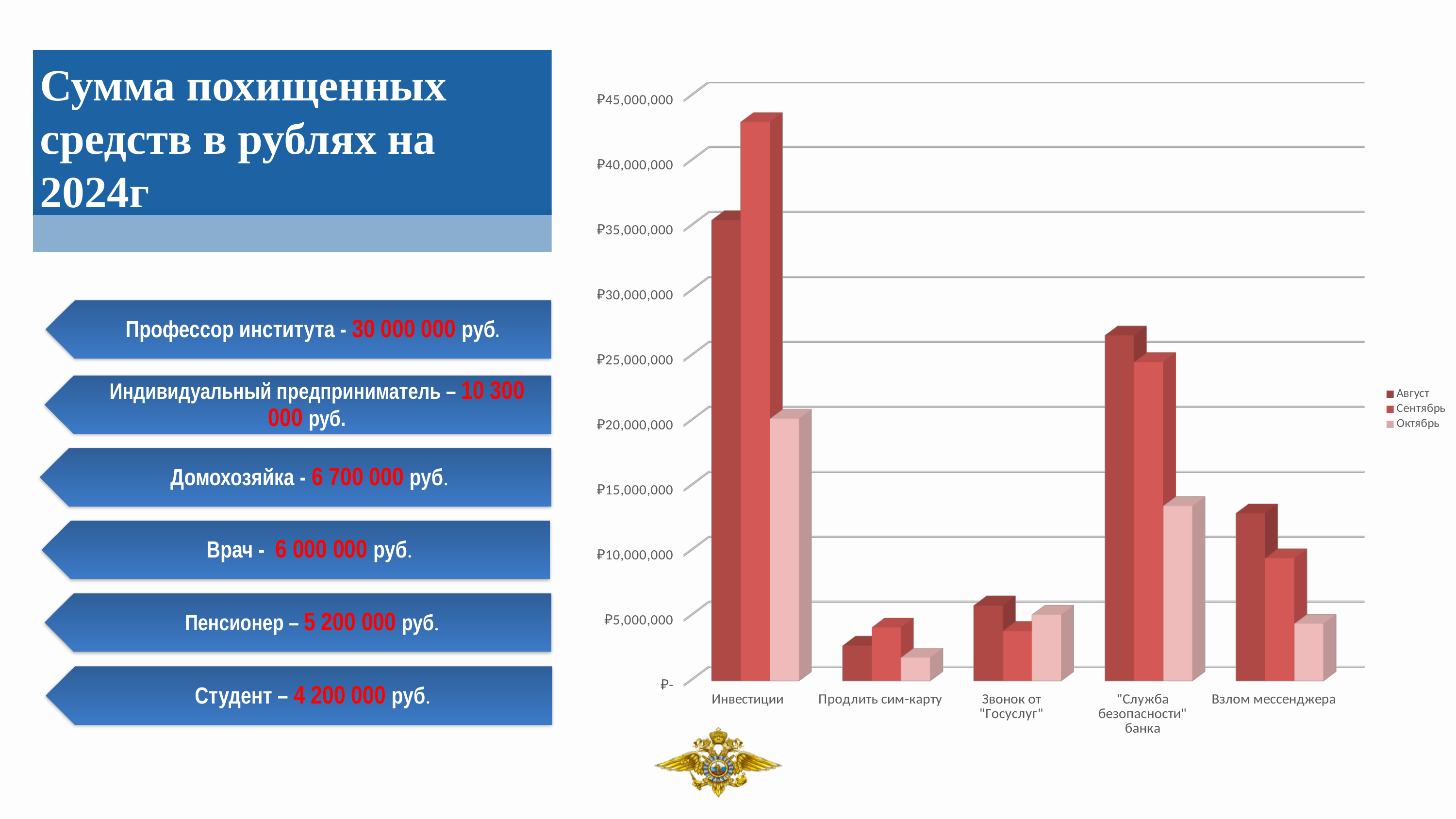
Is the Август value for Взлом мессенджера greater or less than ₽10,000,000? greater How many categories are shown on the x axis of the chart? 5 What kind of chart is shown on the slide? bar chart For Инвестиции, which is larger: the Август value or the Сентябрь value? Сентябрь How many series does the chart legend list? 3 For "Служба безопасности" банка, which is larger: the Август value or the Октябрь value? Август Which category has the highest value for Сентябрь? Инвестиции Is the Сентябрь value for Инвестиции greater or less than ₽40,000,000? greater Is the Октябрь value for Взлом мессенджера greater or less than ₽5,000,000? less What are the three series listed in the chart legend? Август, Сентябрь, Октябрь Which category has the lowest value for Октябрь? Продлить сим-карту